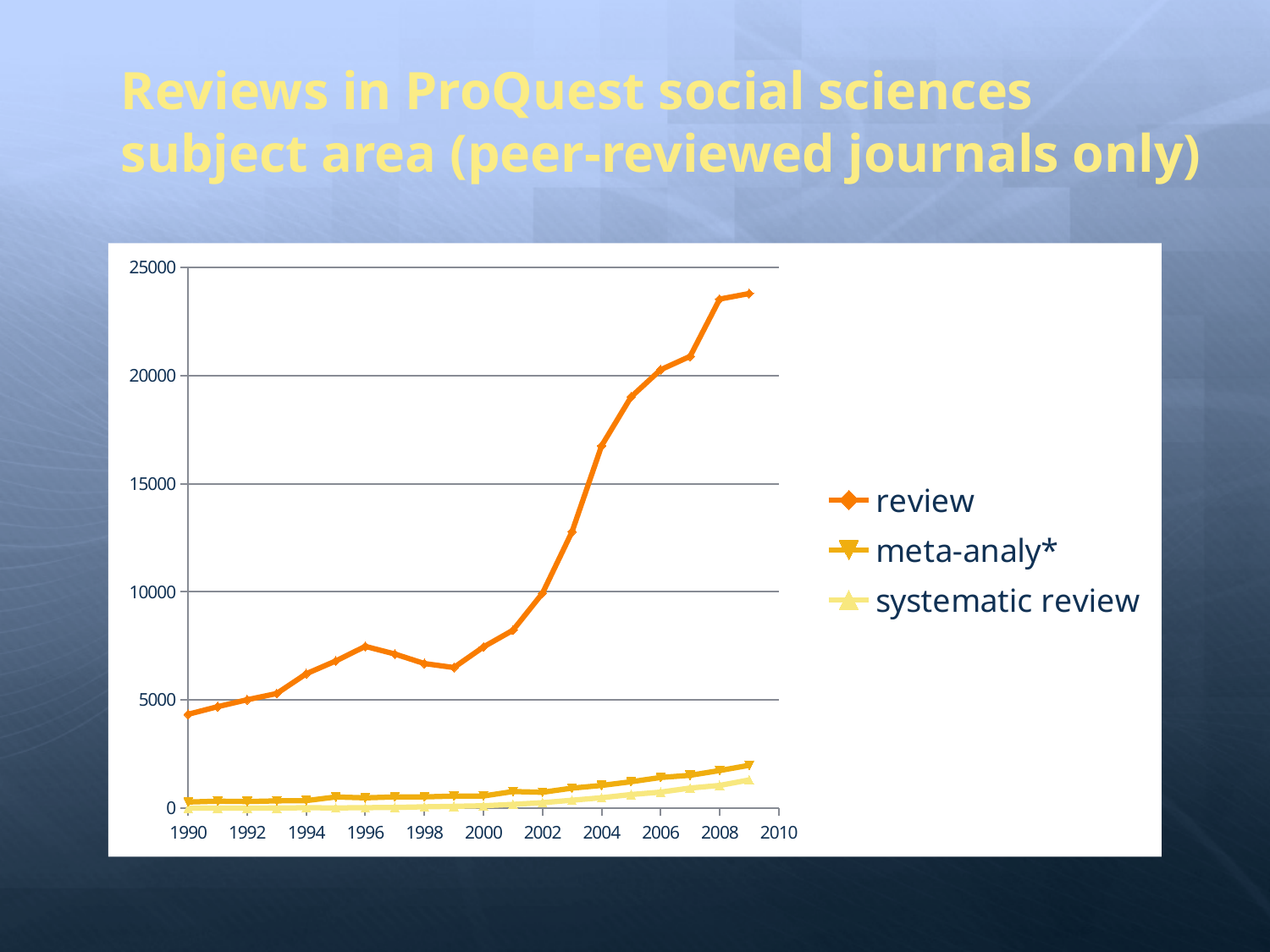
Is the value for meta-analy* in 2009 greater or less than 5000? less Between 1996 and 1999, does the review series rise or fall? fall Overall, does the review series rise or fall from 1990 to 2009? rise How many series does the legend list? 3 Is the value for review in 1990 greater or less than 5000? less Is the value for review in 2004 greater or less than 15000? greater Which series has the lowest value in 2009? systematic review What are the three series named in the legend? review, meta-analy*, systematic review Which series has the highest value in 2009? review What kind of chart is shown on the slide? line chart What is the title of the slide containing the chart? Reviews in ProQuest social sciences subject area (peer-reviewed journals only)